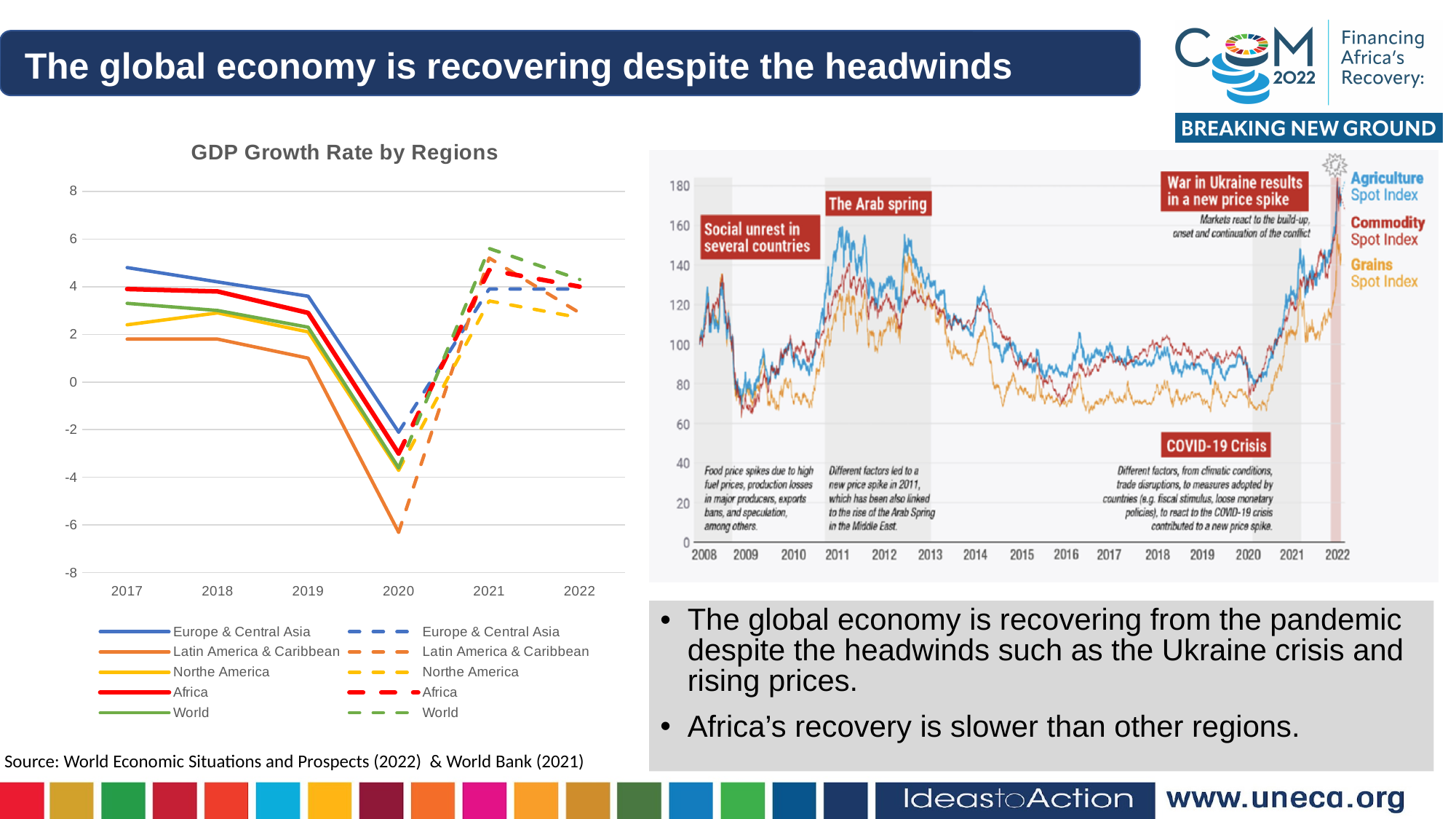
What kind of chart is the 'GDP Growth Rate by Regions' chart on the left? Line chart In the 'GDP Growth Rate by Regions' chart, is the value for Europe & Central Asia in 2017 greater or less than 4? greater In the 'GDP Growth Rate by Regions' chart, how many entries does the legend list? 10 In the 'GDP Growth Rate by Regions' chart, how many years are shown on the x axis? 6 In the 'GDP Growth Rate by Regions' chart, which region has the lowest GDP growth rate in 2020? Latin America & Caribbean In the 'GDP Growth Rate by Regions' chart, does the Europe & Central Asia line rise or fall from 2017 to 2020? Fall In the 'GDP Growth Rate by Regions' chart, is the value for Latin America & Caribbean in 2020 greater or less than -4? less In the 'GDP Growth Rate by Regions' chart, is the value for World in 2020 greater or less than -2? less In the chart on the right, which event is labelled as resulting in a new price spike in 2022? War in Ukraine In the 'GDP Growth Rate by Regions' chart, which is larger in 2020: Europe & Central Asia or Latin America & Caribbean? Europe & Central Asia In the chart on the right, how many spot indices does the legend list? 3 In the 'GDP Growth Rate by Regions' chart, which region has the highest GDP growth rate in 2017? Europe & Central Asia